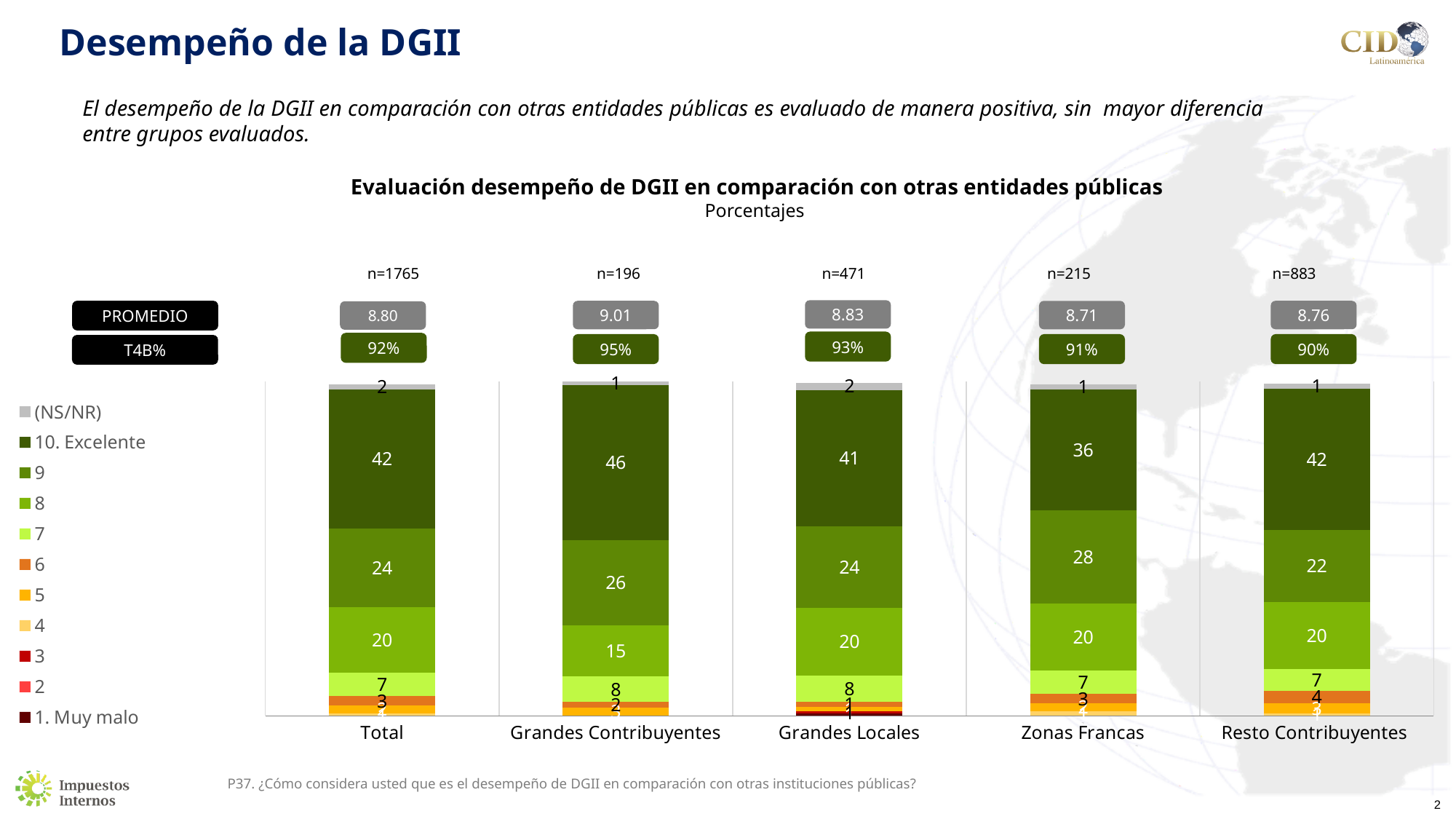
What is the value of '8' for Grandes Contribuyentes? 15 What is the value of '10. Excelente' for Grandes Contribuyentes? 46 How many categories are shown along the x axis of the chart? 5 What type of chart is shown on the slide? stacked bar chart What is the value of '9' for Zonas Francas? 28 How many series does the legend list? 11 Which category has the highest value for '10. Excelente'? Grandes Contribuyentes What is the PROMEDIO value shown for Grandes Locales? 8.83 What is the difference between the '10. Excelente' values for Grandes Contribuyentes and Zonas Francas? 10 What is the T4B% value shown for Resto Contribuyentes? 90% Which is larger: the '9' value for Grandes Contribuyentes or for Resto Contribuyentes? Grandes Contribuyentes Which category has the lowest value for '10. Excelente'? Zonas Francas